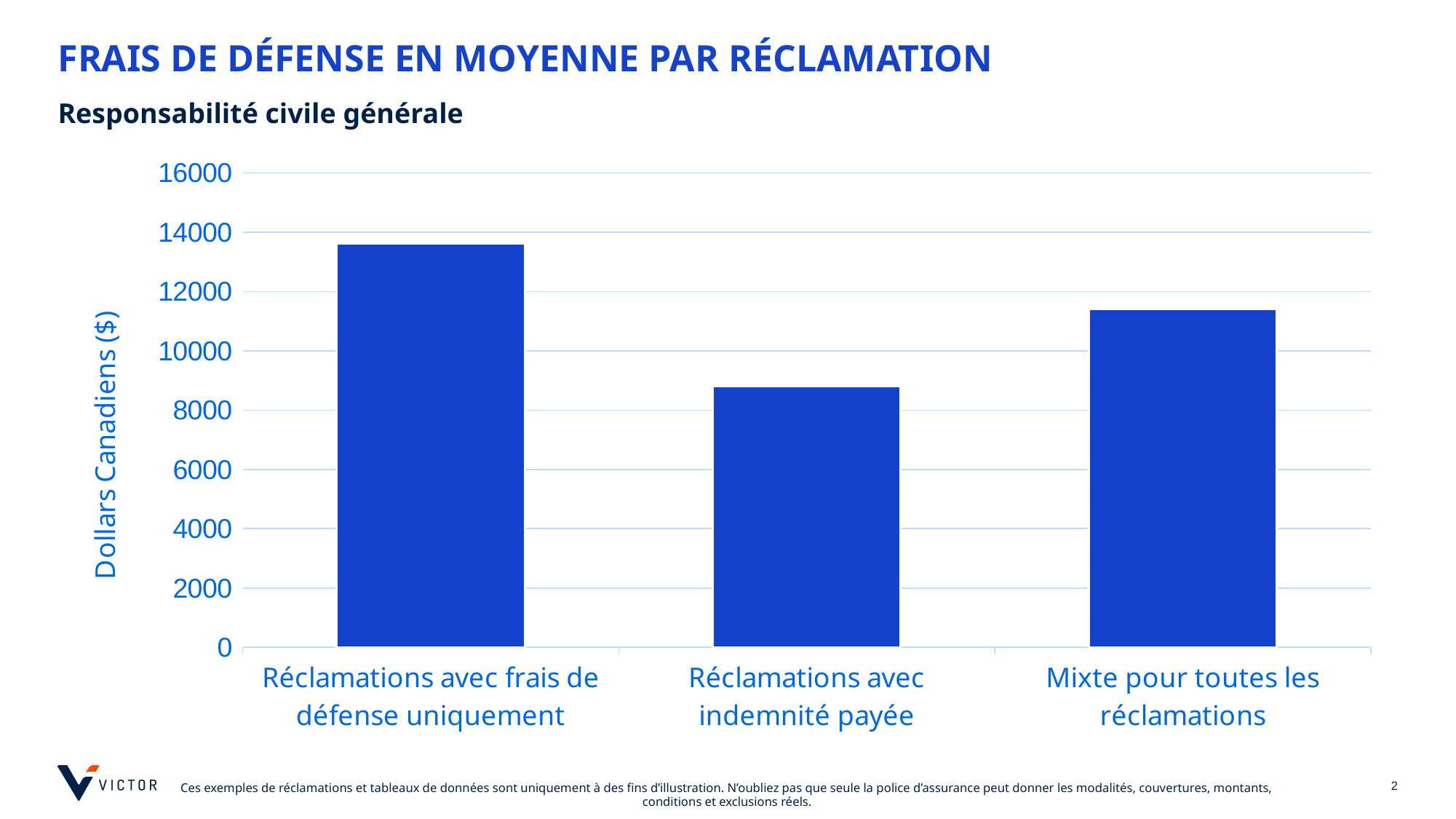
What is the subtitle shown above the chart? Responsabilité civile générale Which category has the highest average defence cost? Réclamations avec frais de défense uniquement Is the value for 'Mixte pour toutes les réclamations' greater or less than 10000? greater What kind of chart is shown on the slide? bar chart Is the value for 'Réclamations avec frais de défense uniquement' greater or less than 12000? greater Is the value for 'Mixte pour toutes les réclamations' greater or less than 12000? less How many categories are plotted on the chart? 3 What is the label of the vertical axis? Dollars Canadiens ($) Which category has the lowest average defence cost? Réclamations avec indemnité payée Which is larger: the value for 'Réclamations avec frais de défense uniquement' or the value for 'Mixte pour toutes les réclamations'? Réclamations avec frais de défense uniquement Which is larger: the value for 'Réclamations avec indemnité payée' or the value for 'Mixte pour toutes les réclamations'? Mixte pour toutes les réclamations